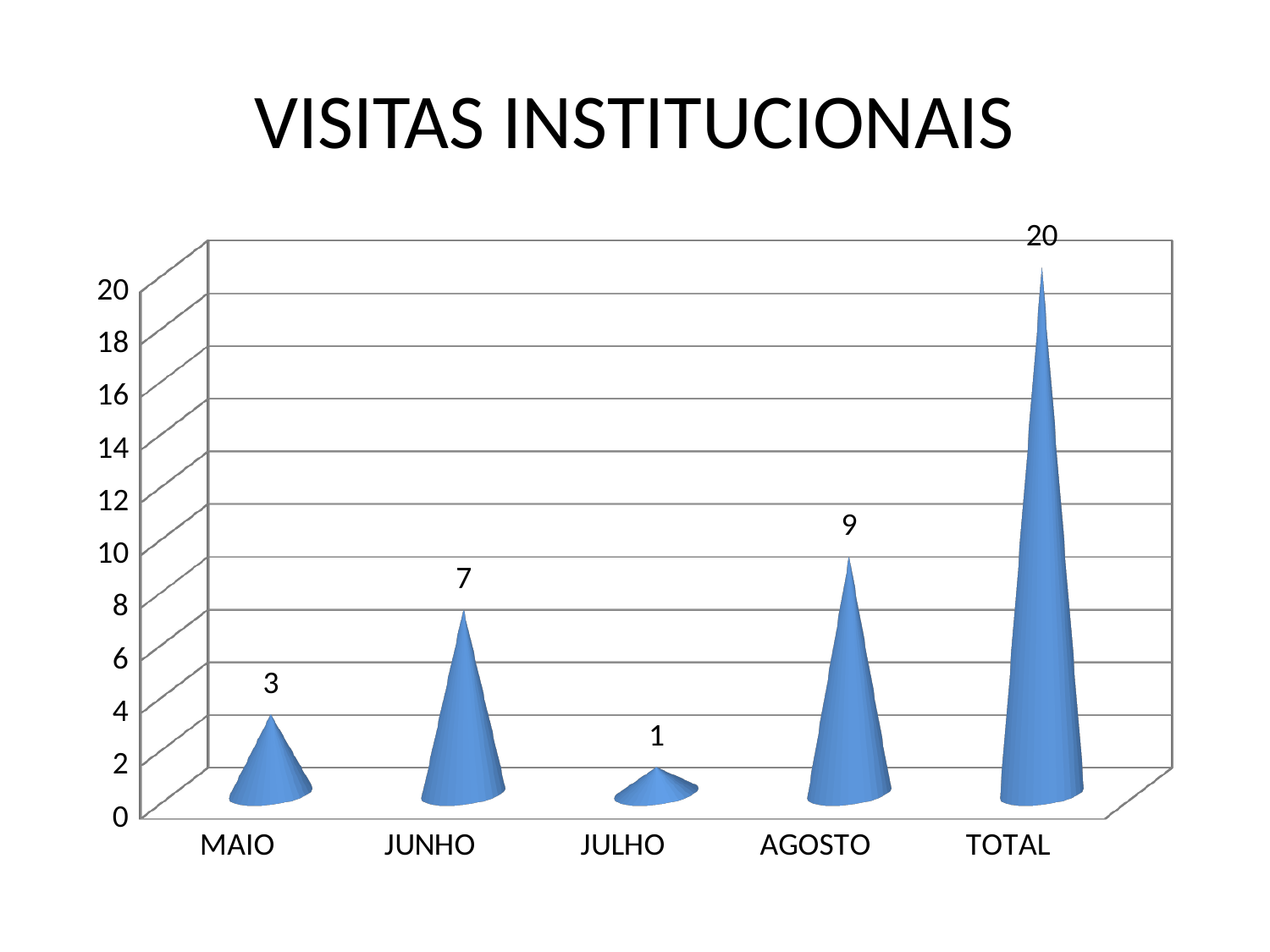
What is the value for AGOSTO? 9 What is the value shown for TOTAL? 20 Which is larger, the value for MAIO or the value for JUNHO? JUNHO What is the value for JUNHO? 7 What is the value for MAIO? 3 What is the title of the chart? VISITAS INSTITUCIONAIS Which category has the highest value? TOTAL How many categories are shown on the x axis? 5 What is the value for JULHO? 1 What is the difference between the values for AGOSTO and JUNHO? 2 Which category has the lowest value? JULHO What kind of chart is this? bar chart